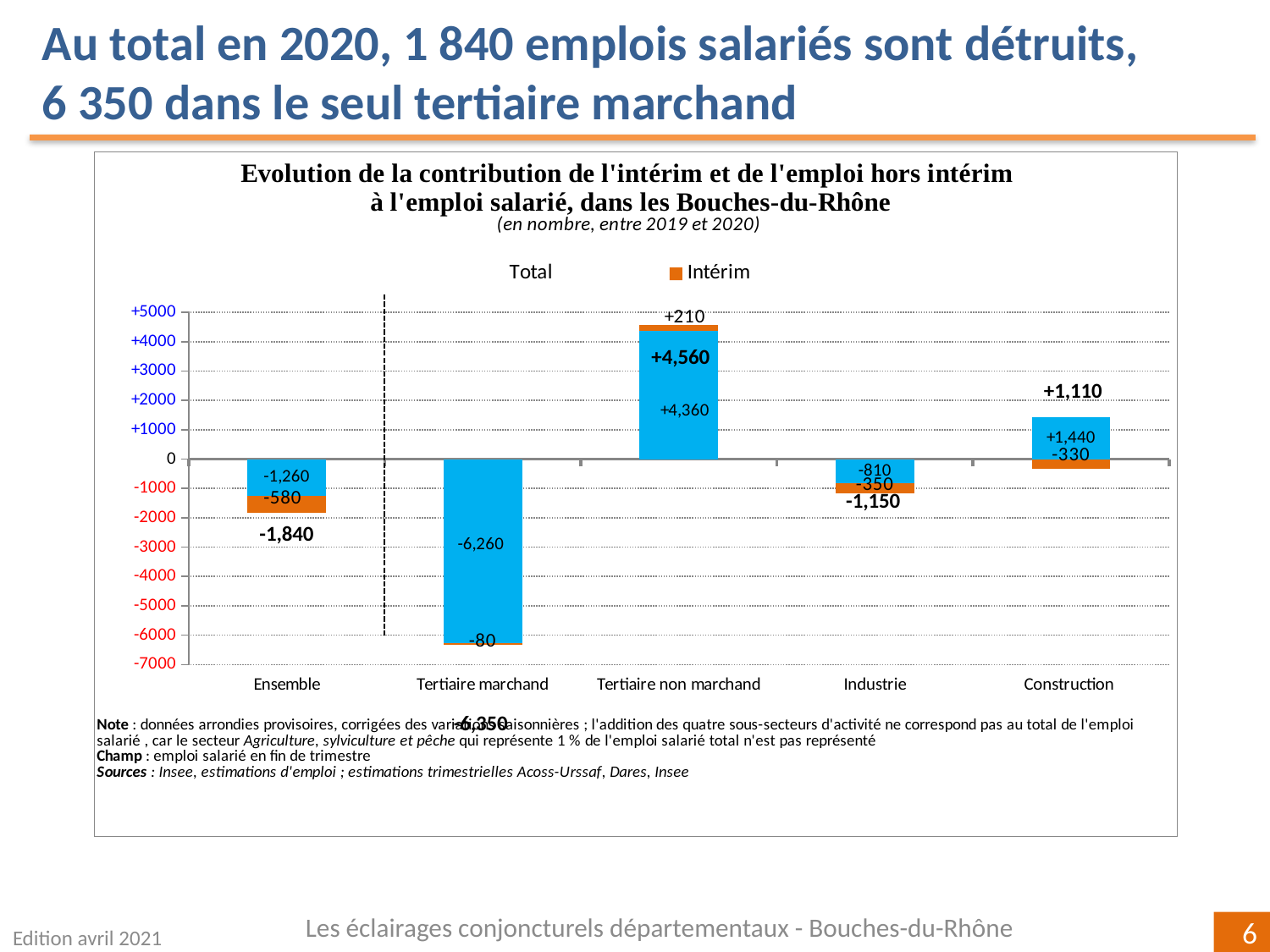
Which has the lower Intérim value, Ensemble or Industrie? Ensemble What is the Intérim value for Construction? -330 What is the value of the blue (hors intérim) segment for Tertiaire non marchand? +4,360 What is the difference between the total for Ensemble (-1,840) and the total for Industrie (-1,150)? 690 Which sector has the highest total? Tertiaire non marchand How many series does the legend list? 2 Which sector has the lowest total? Tertiaire marchand What is the total shown for Industrie? -1,150 How many sectors are shown on the x axis? 5 What kind of chart is shown? Stacked bar chart What is the Intérim value for Ensemble? -580 What is the total shown for Tertiaire non marchand? +4,560